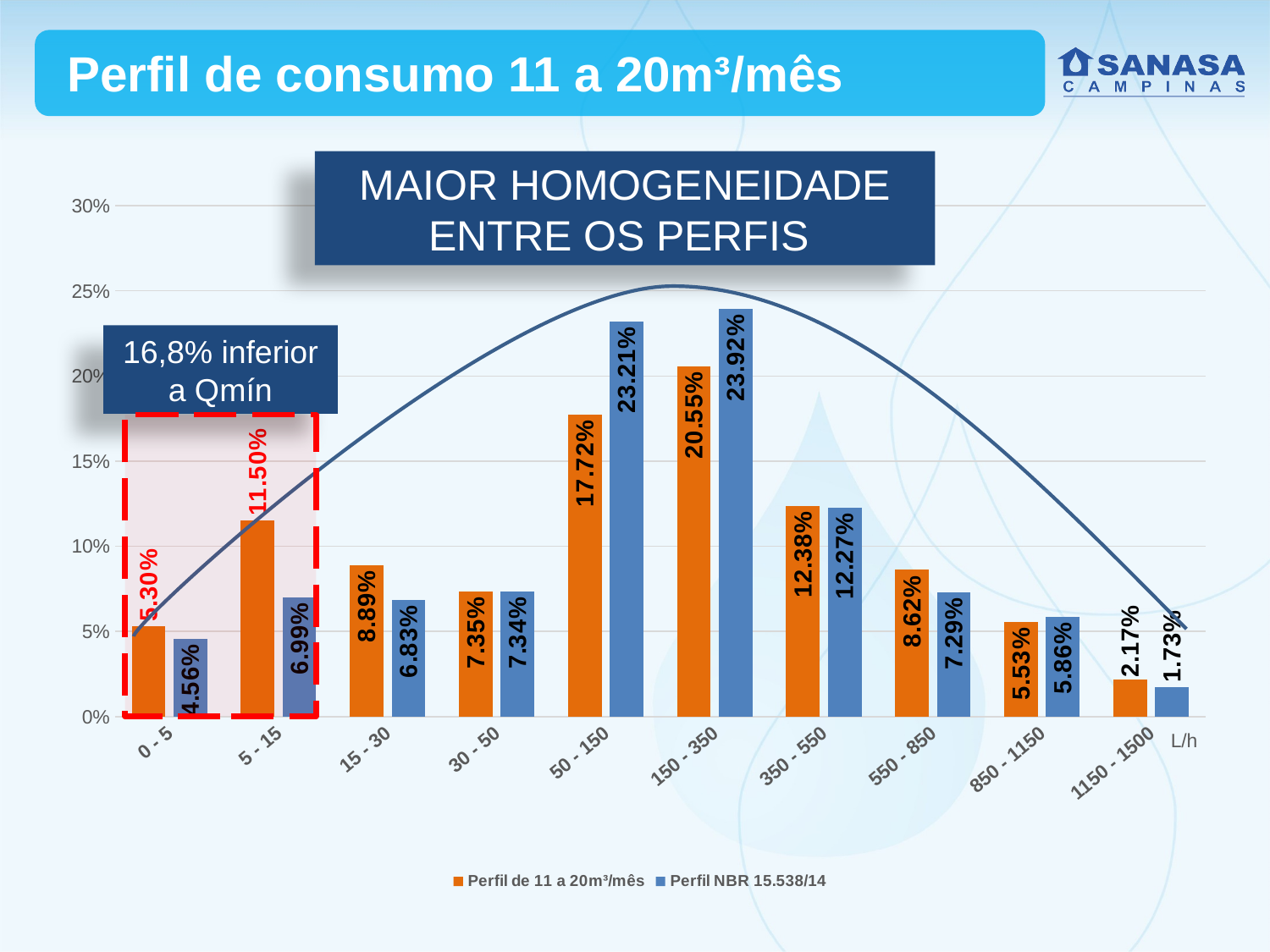
Which category has the lowest value in the Perfil de 11 a 20m³/mês series? 1150 - 1500 Which category has the highest value in the Perfil NBR 15.538/14 series? 150 - 350 What colour represents the Perfil NBR 15.538/14 series in the chart? Blue What is the difference between the Perfil NBR 15.538/14 and Perfil de 11 a 20m³/mês values for the 50 - 150 L/h category? 5.49% What is the value of the Perfil de 11 a 20m³/mês series for the 5 - 15 L/h category? 11.50% What is the value of the Perfil de 11 a 20m³/mês series for the 150 - 350 L/h category? 20.55% How many series does the chart legend list? 2 How many L/h categories are shown on the x axis of the chart? 10 Is the Perfil de 11 a 20m³/mês value for the 150 - 350 L/h category greater or less than 20%? greater For the 5 - 15 L/h category, which series has the larger value: Perfil de 11 a 20m³/mês or Perfil NBR 15.538/14? Perfil de 11 a 20m³/mês What type of chart is shown on the slide? Bar chart What is the value of the Perfil NBR 15.538/14 series for the 50 - 150 L/h category? 23.21%